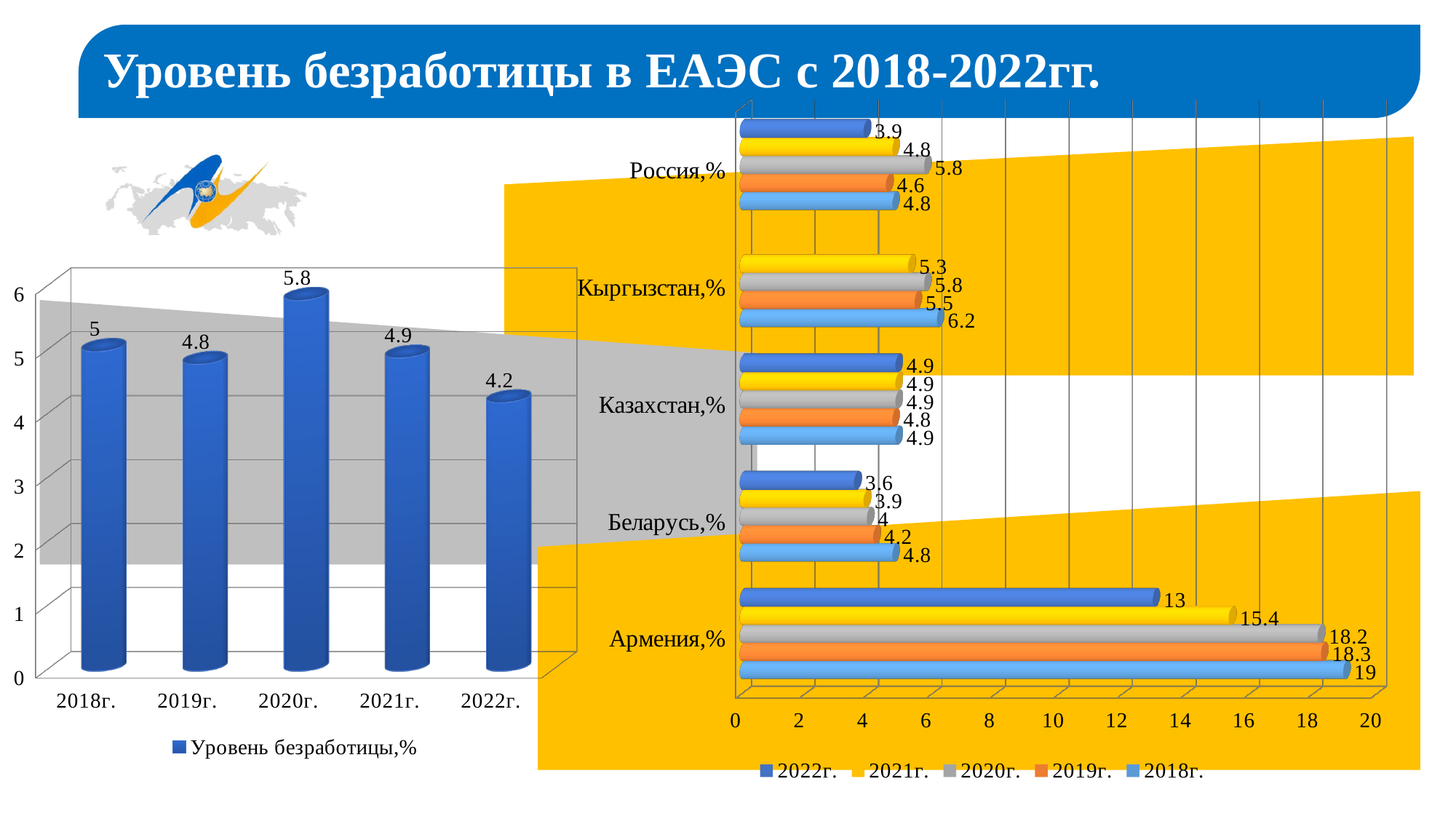
In the right chart, which country has the highest values overall? Армения,% In the left chart, what kind of chart is used? bar chart In the left chart, what is the difference between the values for 2020г. and 2022г.? 1.6 In the right chart, what is the difference between the 2019г. and 2022г. values for Армения,%? 5.3 In the right chart, how many series does the legend list? 5 In the right chart, what is the value for Беларусь,% in 2022г.? 3.6 In the right chart, do the values for Армения,% rise or fall from 2018г. to 2022г.? fall In the right chart, which is larger: the 2021г. value for Кыргызстан,% or the 2021г. value for Россия,%? Кыргызстан,% In the left chart, which year has the lowest unemployment rate? 2022г. In the right chart, what is the value for Армения,% in 2018г.? 19 In the left chart, what is the unemployment rate for 2020г.? 5.8 In the left chart, how many years are shown on the x axis? 5